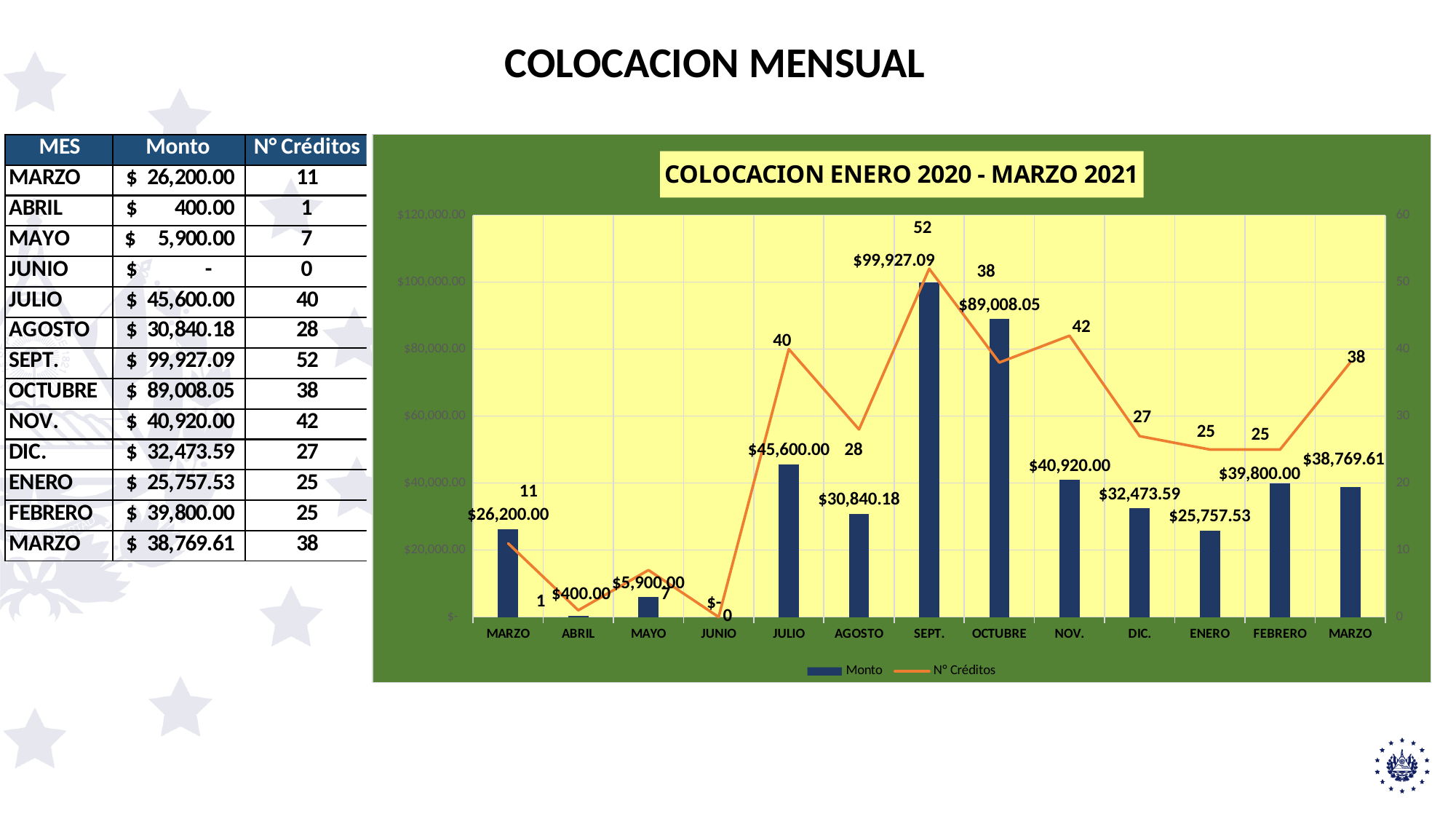
What is the N° Créditos value for NOV.? 42 Does the N° Créditos line rise or fall from DIC. to FEBRERO? fall What kind of chart is used to show the Monto series? bar chart Which month has the lowest N° Créditos? JUNIO Which is larger, the Monto for JULIO or the Monto for AGOSTO? JULIO What is the title of the chart? COLOCACION ENERO 2020 - MARZO 2021 Which month has the highest Monto? SEPT. How many series does the chart legend list? 2 What is the Monto value for SEPT.? $99,927.09 What is the difference in N° Créditos between SEPT. and OCTUBRE? 14 How many months are shown on the x axis of the chart? 13 Is the Monto for OCTUBRE greater or less than $80,000.00? greater